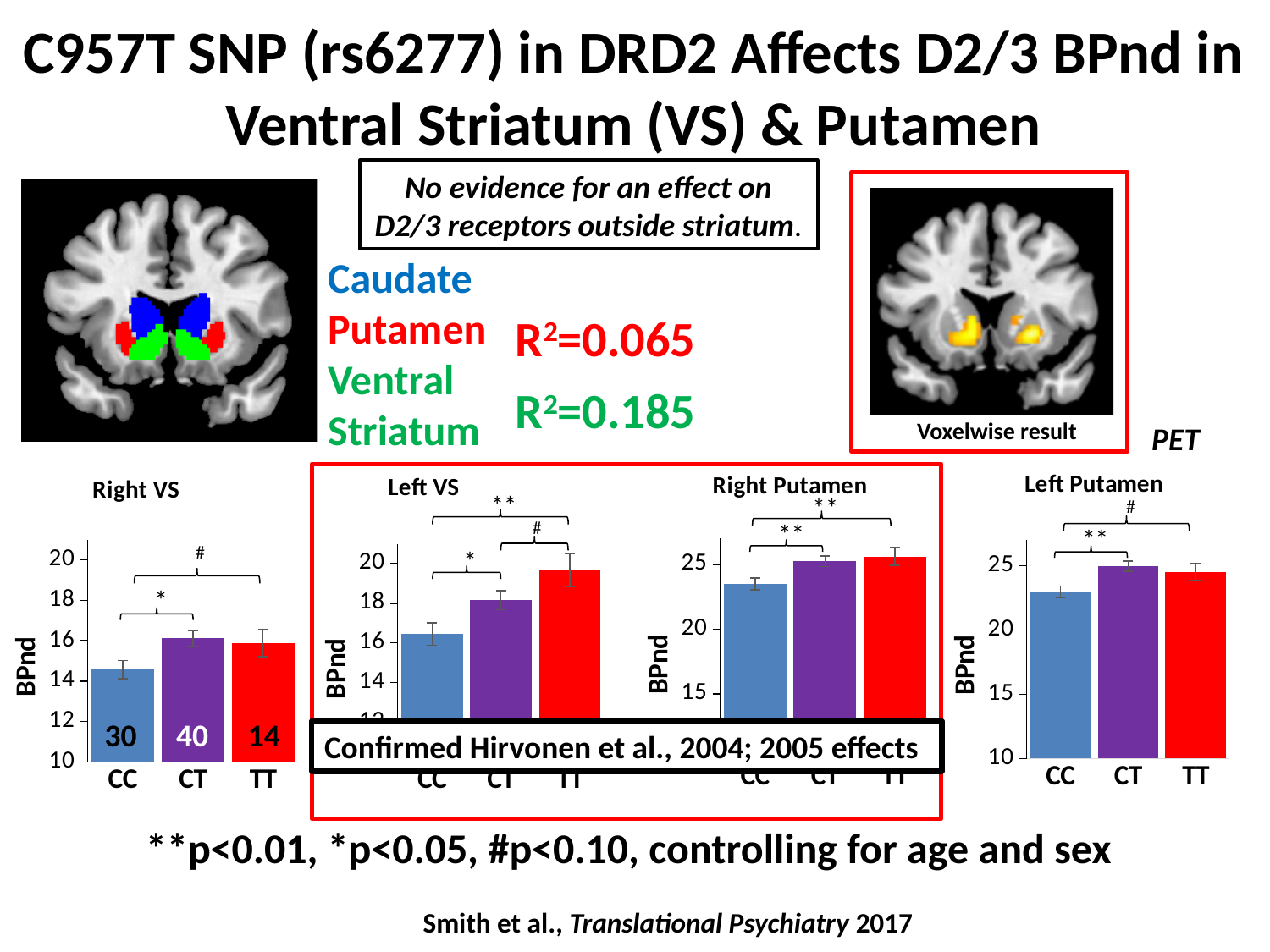
In the Left VS chart, which genotype has the lowest BPnd? CC In the Left VS chart, which is larger, the value for CC or the value for CT? CT In the Right Putamen chart, is the value for CC greater or less than 25? less In the Left VS chart, do the values rise or fall from CC to TT? rise How many categories are shown on the x axis of the Right Putamen chart? 3 In the Right VS chart, is the value for CC greater or less than 16? less In the Left VS chart, is the value for TT greater or less than 18? greater In the Left VS chart, which genotype has the highest BPnd? TT In the Right VS chart, which genotype has the lowest BPnd? CC What kind of chart is the Left VS chart? bar chart In the Right Putamen chart, which genotype has the lowest BPnd? CC